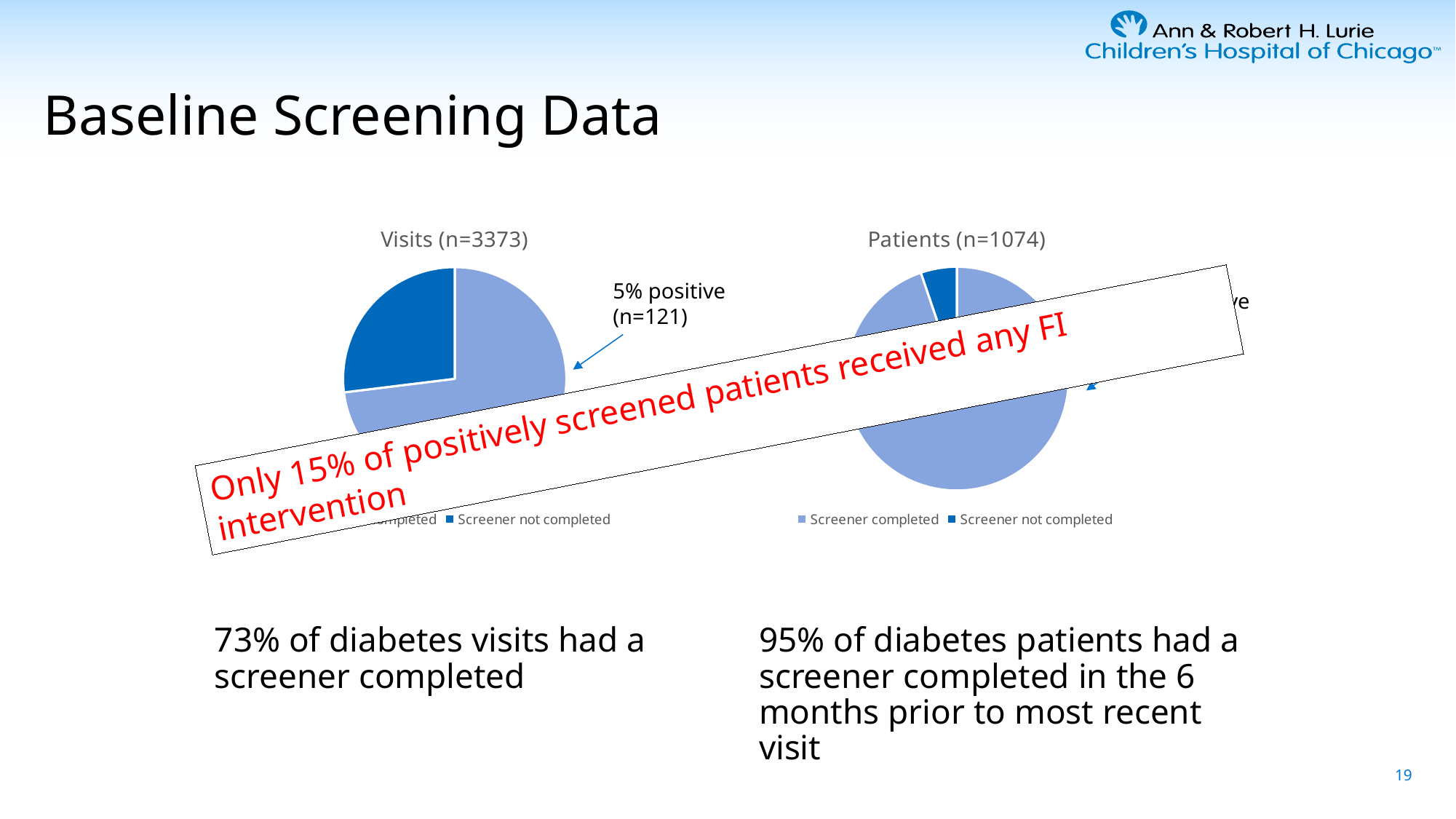
In the Visits (n=3373) chart, what percentage of visits is annotated as positive? 5% How many entries does the legend of the Patients (n=1074) chart list? 2 What is the title of the right-hand pie chart? Patients (n=1074) How many slices does the Patients (n=1074) pie chart have? 2 According to the slide, what share of diabetes visits in the Visits (n=3373) chart had a screener completed? 73% According to the slide, what share of diabetes patients in the Patients (n=1074) chart had a screener completed? 95% In the Visits (n=3373) chart, which category has the smallest slice? Screener not completed In the Visits (n=3373) chart, which slice is larger: Screener completed or Screener not completed? Screener completed What kind of chart is the Visits (n=3373) chart? pie chart In the Patients (n=1074) chart, which slice is larger: Screener completed or Screener not completed? Screener completed In the Visits (n=3373) chart, how many visits are annotated as positive? n=121 What is the title of the left-hand pie chart? Visits (n=3373)